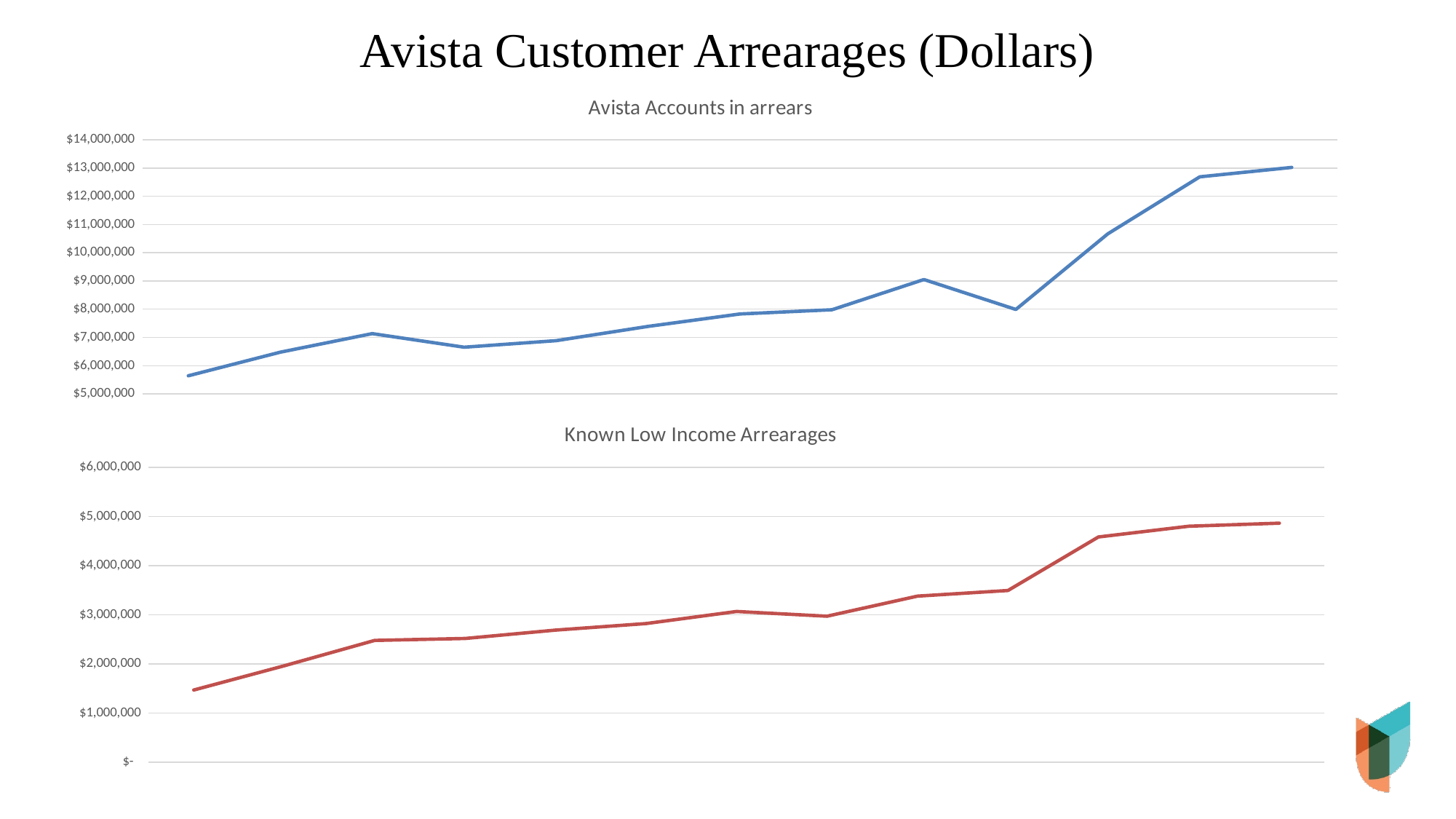
In the "Known Low Income Arrearages" chart, is the first (leftmost) value greater or less than $1,000,000? greater In the "Avista Accounts in arrears" chart, is the last (rightmost) value greater or less than $12,000,000? greater What kind of chart is the "Known Low Income Arrearages" chart? line chart In the "Avista Accounts in arrears" chart, is the highest point on the line at the left end or the right end? right end What kind of chart is the "Avista Accounts in arrears" chart? line chart What is the title of the top chart on the slide? Avista Accounts in arrears In the "Avista Accounts in arrears" chart, do the values generally rise or fall from left to right? rise In the "Avista Accounts in arrears" chart, is the first (leftmost) value greater or less than $6,000,000? less In the "Known Low Income Arrearages" chart, do the values generally rise or fall from left to right? rise In the "Known Low Income Arrearages" chart, is the lowest point on the line at the left end or the right end? left end What colour is the line in the "Known Low Income Arrearages" chart? red